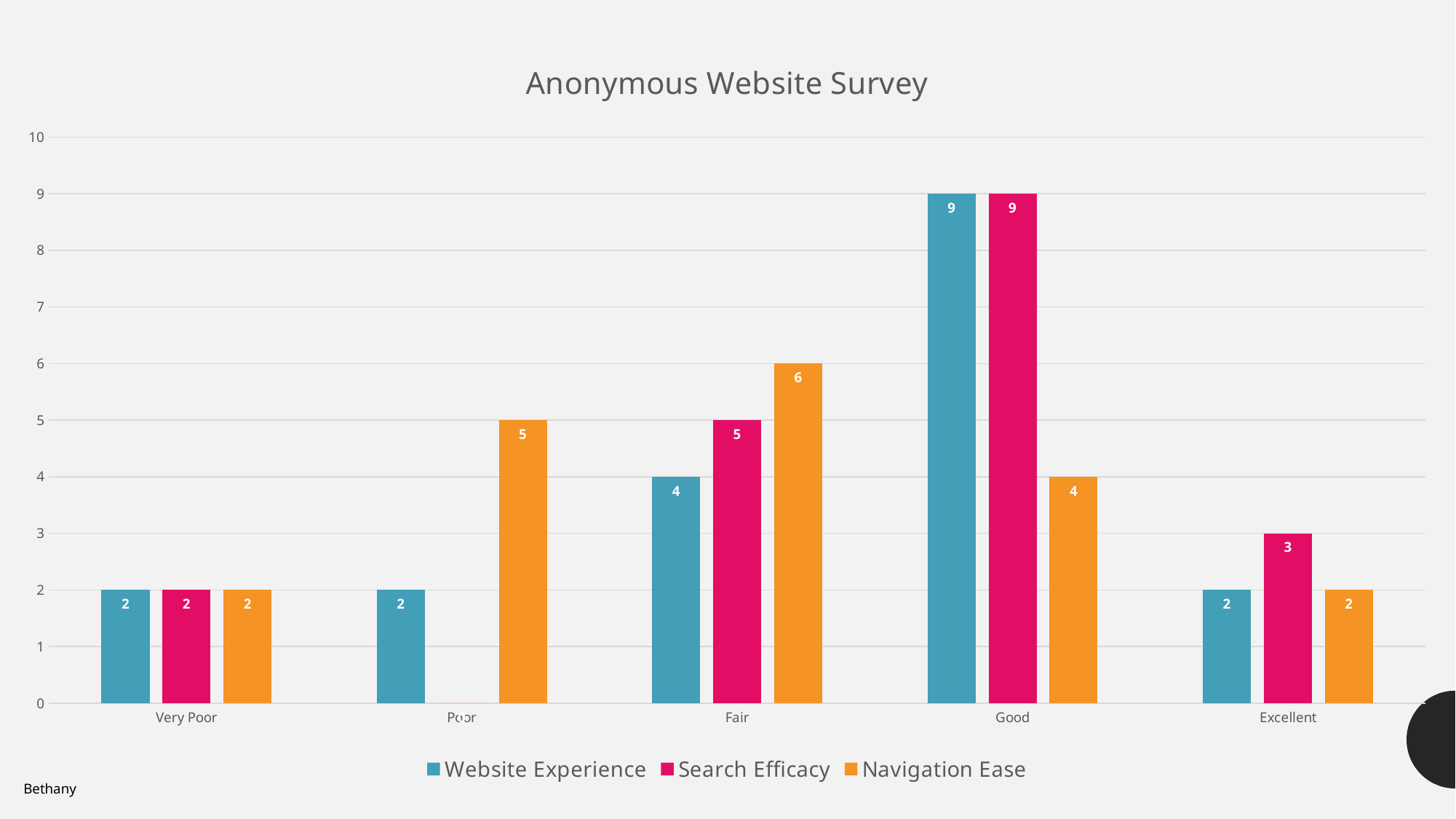
How many categories are shown on the x axis? 5 What is the title of the chart? Anonymous Website Survey Which category has the highest value for Website Experience? Good How many series does the legend list? 3 What is the value for Navigation Ease in the Poor category? 5 What is the value for Navigation Ease in the Fair category? 6 What kind of chart is shown on the slide? Bar chart What is the value for Search Efficacy in the Excellent category? 3 What is the value for Website Experience in the Good category? 9 Which is larger in the Fair category, Search Efficacy or Website Experience? Search Efficacy What is the difference between Navigation Ease and Website Experience in the Good category? 5